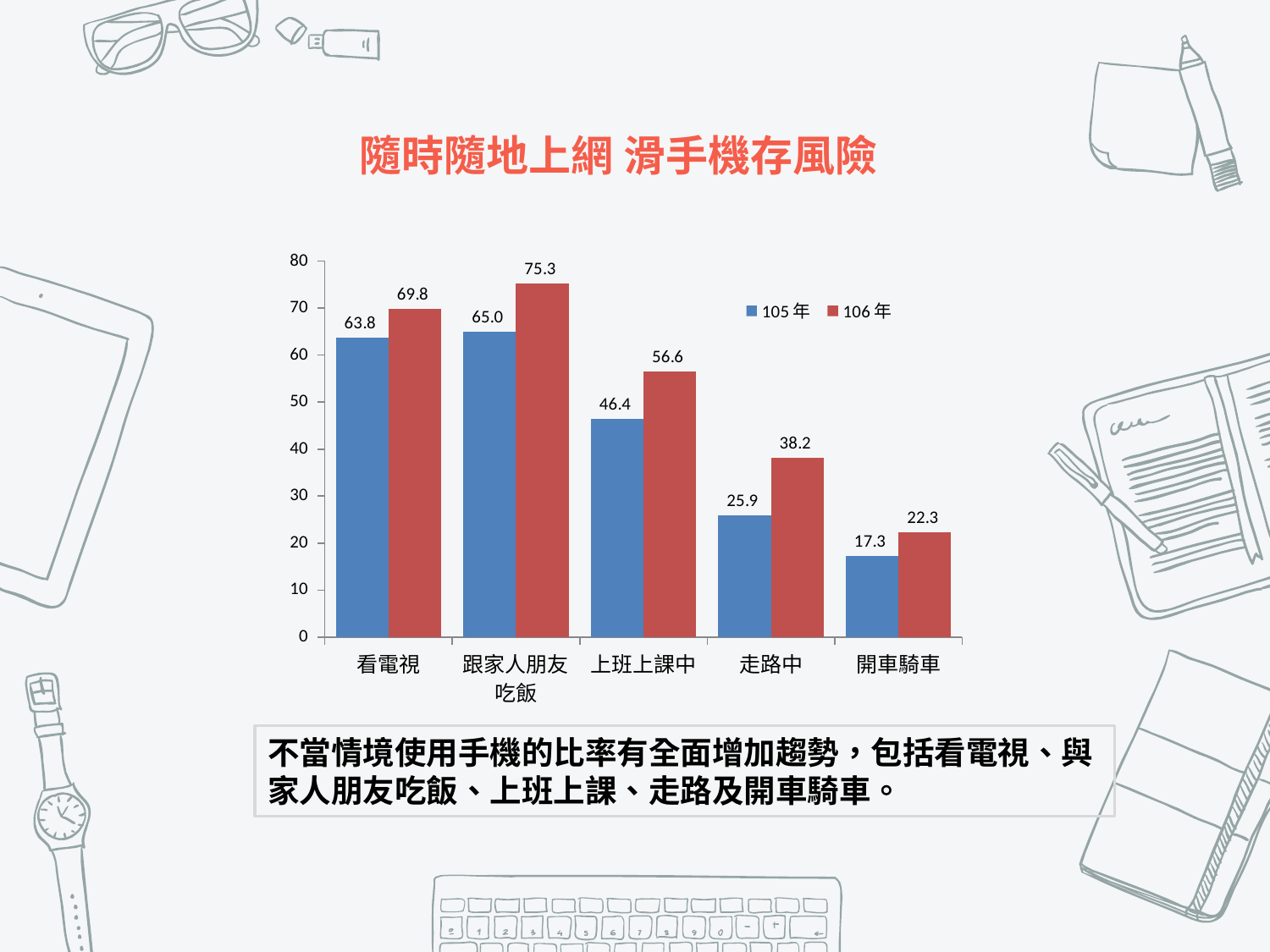
How many categories are shown on the x axis? 5 What is the difference between the 106 年 and 105 年 values for 上班上課中? 10.2 Which is larger for 開車騎車: the 105 年 value or the 106 年 value? 106 年 Is the 106 年 value for 走路中 greater or less than 30? greater How many series does the legend list? 2 What kind of chart is shown on the slide? bar chart Which category has the lowest value in the 105 年 series? 開車騎車 What is the value for 看電視 in the 105 年 series? 63.8 What is the value for 走路中 in the 105 年 series? 25.9 What is the value for 跟家人朋友吃飯 in the 106 年 series? 75.3 What colour are the bars for the 106 年 series? red Which category has the highest value in the 106 年 series? 跟家人朋友吃飯